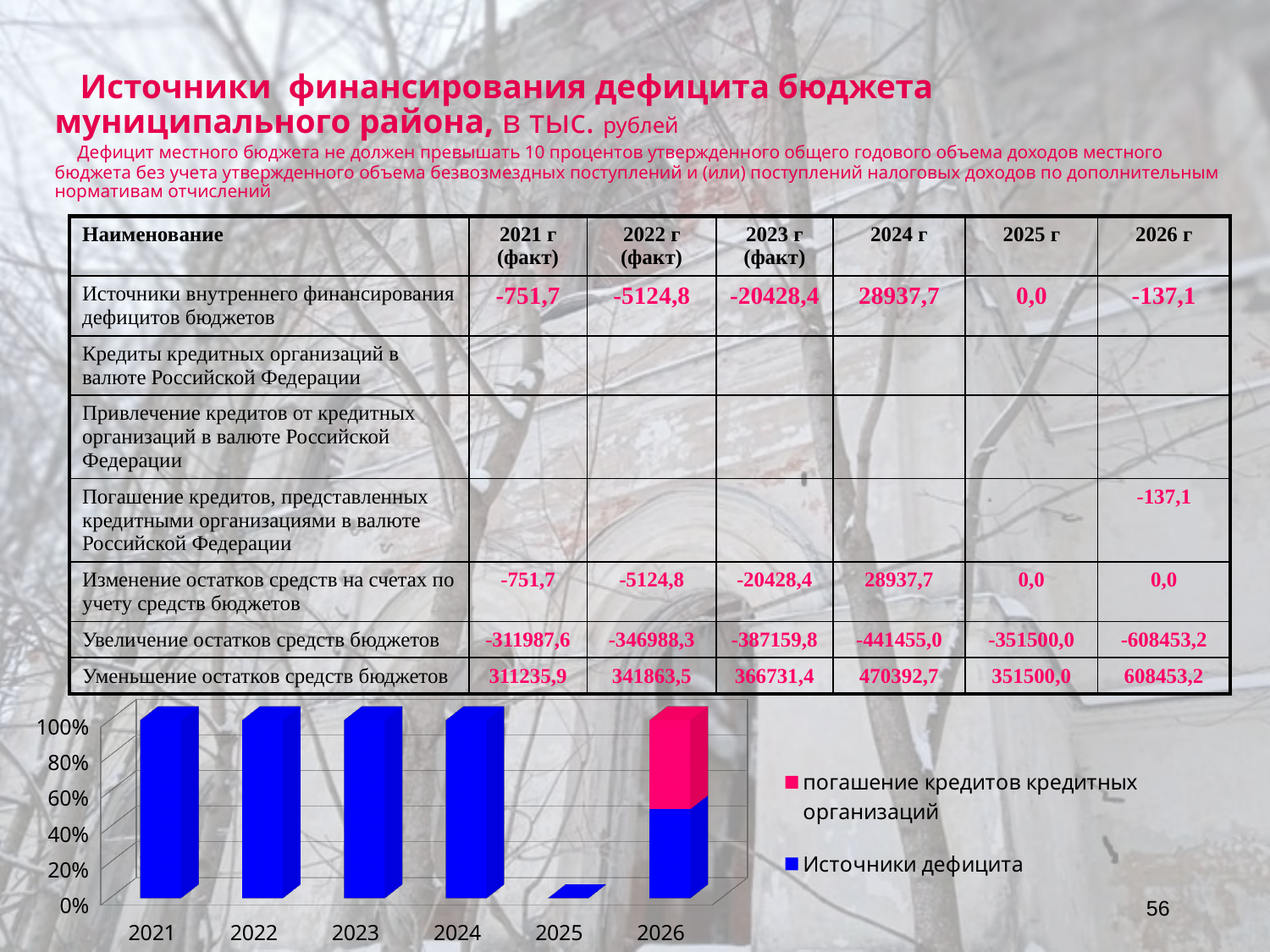
In which year does the pink series (погашение кредитов кредитных организаций) appear in the chart? 2026 How many series does the chart legend list? 2 In how many years does the Источники дефицита bar reach 100% in the chart? 4 How many years are shown on the x axis of the chart? 6 Which is larger in the chart: the Источники дефицита bar for 2021 or for 2025? 2021 Is the share of Источники дефицита in 2026 greater or less than 80%? less Which year has the lowest bar for Источники дефицита in the chart? 2025 Which series is shown in pink in the chart? погашение кредитов кредитных организаций Is the share of Источники дефицита in 2025 greater or less than 20%? less Is the share of погашение кредитов кредитных организаций in 2026 greater or less than 20%? greater Which series is shown in blue in the chart? Источники дефицита What kind of chart is shown at the bottom of the slide? bar chart